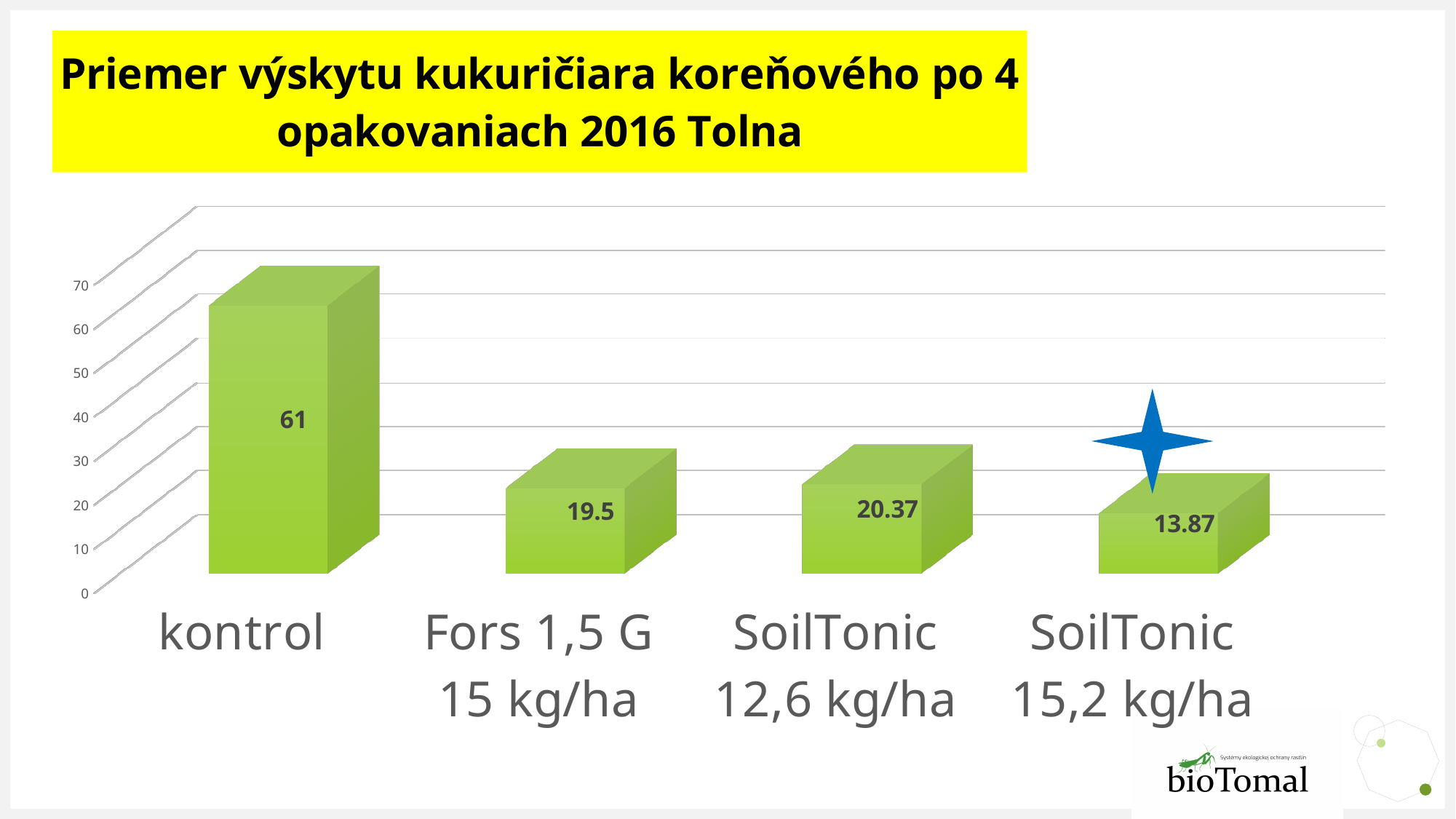
Which category has the lowest value? SoilTonic 15,2 kg/ha What is the title of the chart? Priemer výskytu kukuričiara koreňového po 4 opakovaniach 2016 Tolna What is the value for Fors 1,5 G 15 kg/ha? 19.5 What is the difference between the values for SoilTonic 12,6 kg/ha and Fors 1,5 G 15 kg/ha? 0.87 Which category has the highest value? kontrol How many categories are shown in the chart? 4 What is the value for kontrol? 61 What is the difference between the values for kontrol and SoilTonic 15,2 kg/ha? 47.13 What is the value for SoilTonic 15,2 kg/ha? 13.87 What is the value for SoilTonic 12,6 kg/ha? 20.37 What kind of chart is shown on the slide? bar chart Which is larger, the value for Fors 1,5 G 15 kg/ha or the value for SoilTonic 15,2 kg/ha? Fors 1,5 G 15 kg/ha